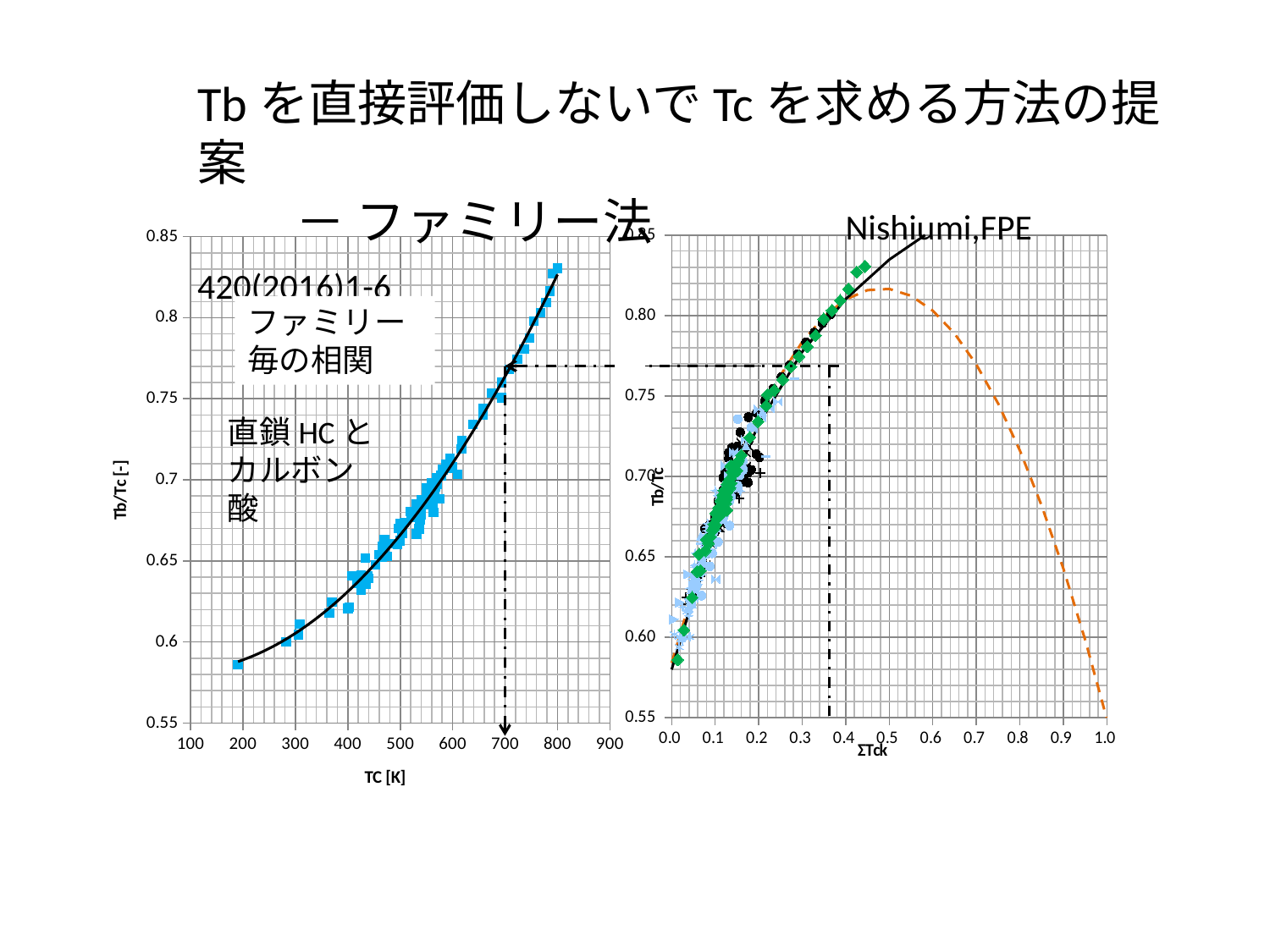
In the left chart, is the Tb/Tc value of the point near Tc = 200 K greater or less than 0.6? less In the left chart, which point has the highest Tb/Tc value: the one near Tc = 200 K or the one near Tc = 800 K? the one near Tc = 800 K In the left chart, what is the label of the horizontal axis? Tc [K] In the left chart, is the Tb/Tc value of the points near Tc = 500 K greater or less than 0.7? less What kind of chart is the right chart (Tb/Tc versus ΣTck)? scatter chart In the right chart, do the plotted Tb/Tc points rise or fall as ΣTck increases from 0.0 to 0.4? rise In the left chart, is the Tb/Tc value of the point near Tc = 800 K greater or less than 0.8? greater What kind of chart is the left chart (Tb/Tc versus Tc [K])? scatter chart In the left chart, do the plotted Tb/Tc values rise or fall as Tc increases from 200 to 800 K? rise In the right chart, what is the label of the horizontal axis? ΣTck